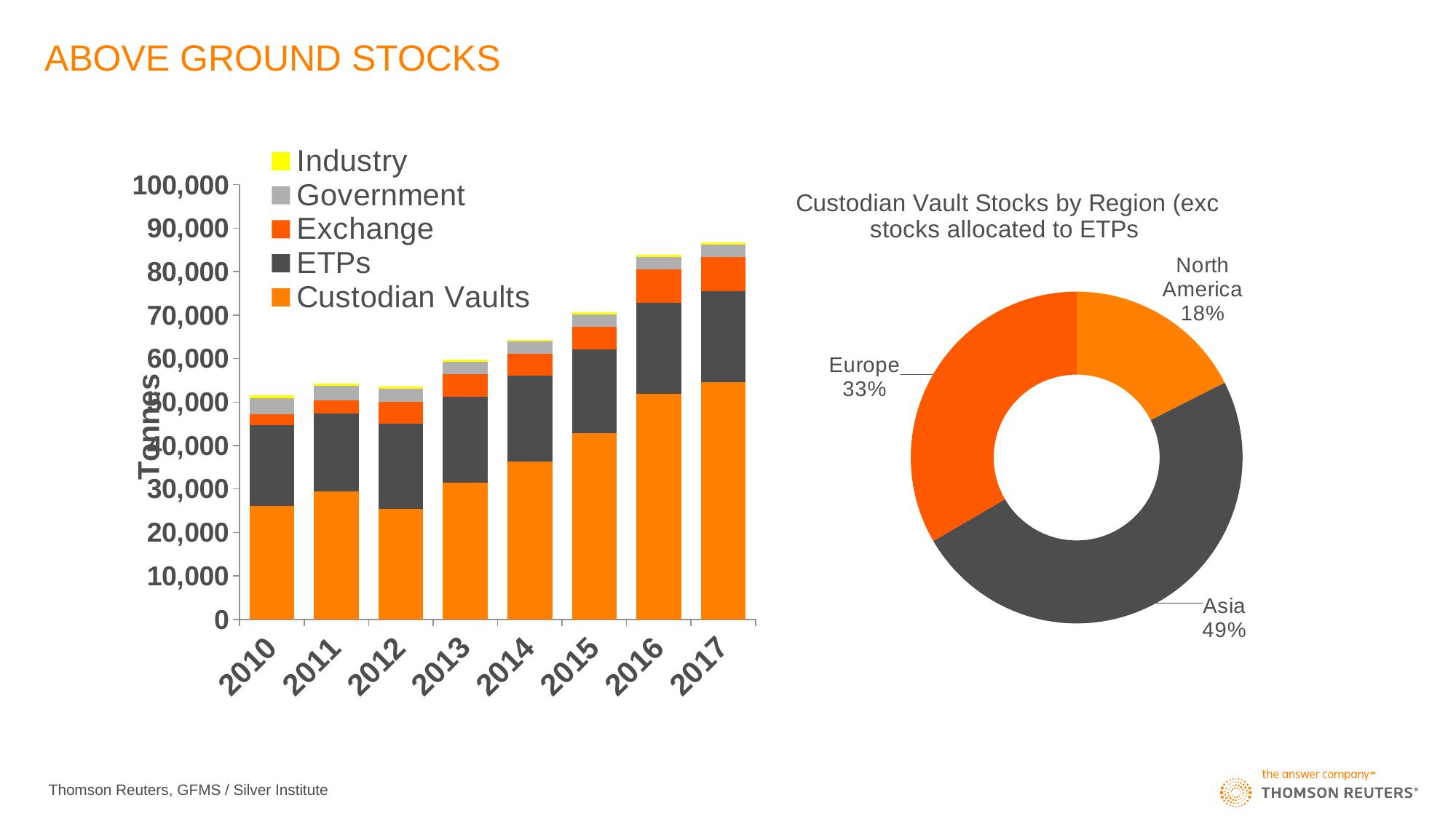
On the left chart, do the total stacked bars generally rise or fall from 2010 to 2017? rise On the Custodian Vault Stocks by Region chart, what share does Asia have? 49% On the left chart, is the total for 2010 greater or less than 60,000? less On the left chart, is the total for 2017 greater or less than 80,000? greater On the left chart, is the Custodian Vaults value for 2017 greater or less than 50,000? greater On the left chart, which year has the highest total stacked bar? 2017 On the Custodian Vault Stocks by Region chart, what is the difference between the shares of Asia and Europe? 16% On the left chart, how many years are shown on the x axis? 8 What kind of chart is the left chart? Stacked bar chart On the left chart, what is the label of the y axis? Tonnes On the left chart, how many series does the legend list? 5 On the Custodian Vault Stocks by Region chart, which region has the smallest share? North America